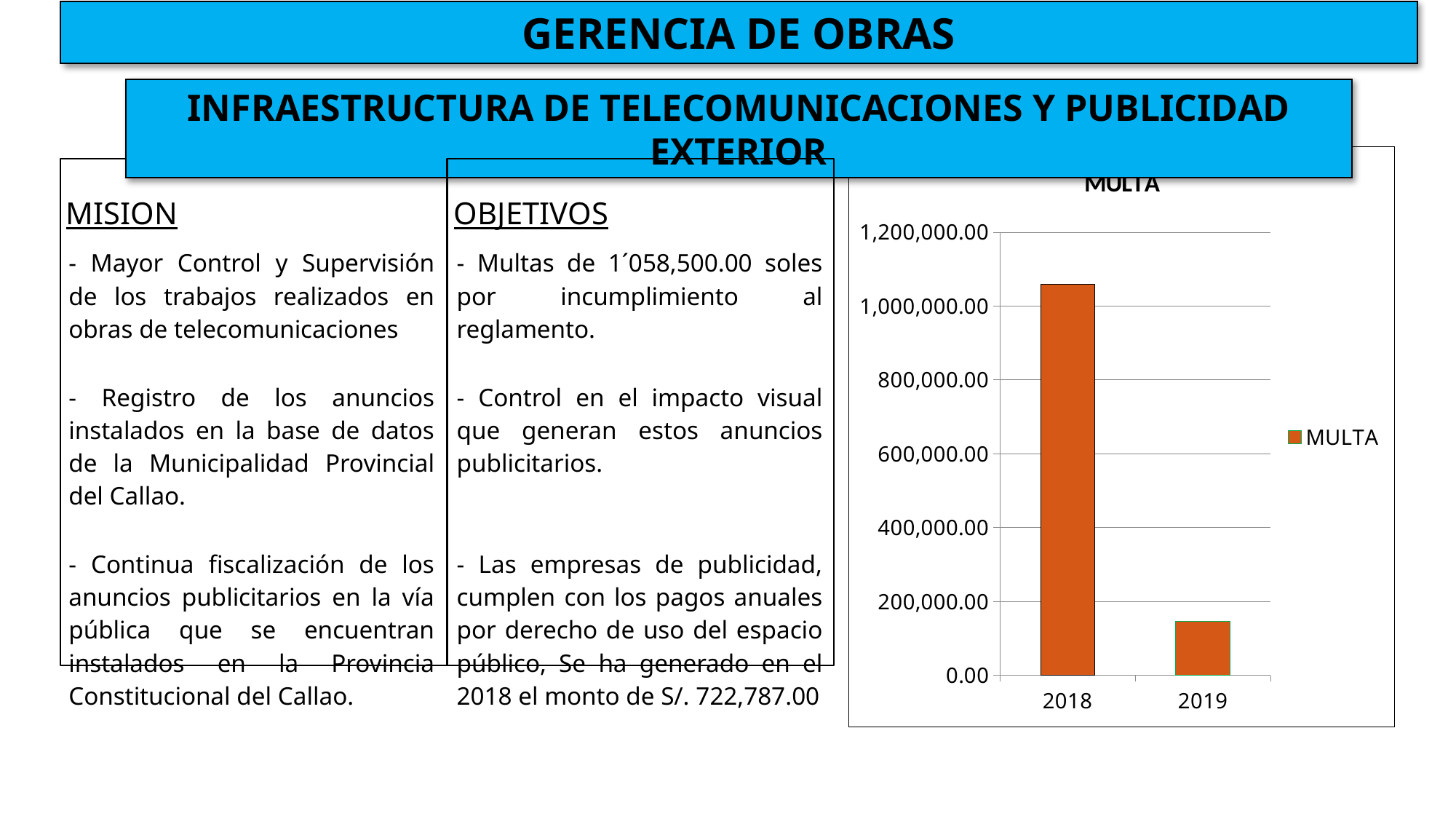
Is the MULTA value for 2019 greater or less than 200,000.00? less How many series does the chart legend list? 1 Is the MULTA value for 2018 greater or less than 1,000,000.00? greater What series name appears in the chart legend? MULTA What kind of chart is shown on the slide? bar chart Do the MULTA values rise or fall from 2018 to 2019? fall What is the title of the chart? MULTA How many categories are shown on the x axis of the chart? 2 Which year has the highest MULTA value? 2018 Is the MULTA value for 2018 greater or less than 1,200,000.00? less Which year has the lowest MULTA value? 2019 Which is larger, the MULTA value for 2018 or for 2019? 2018